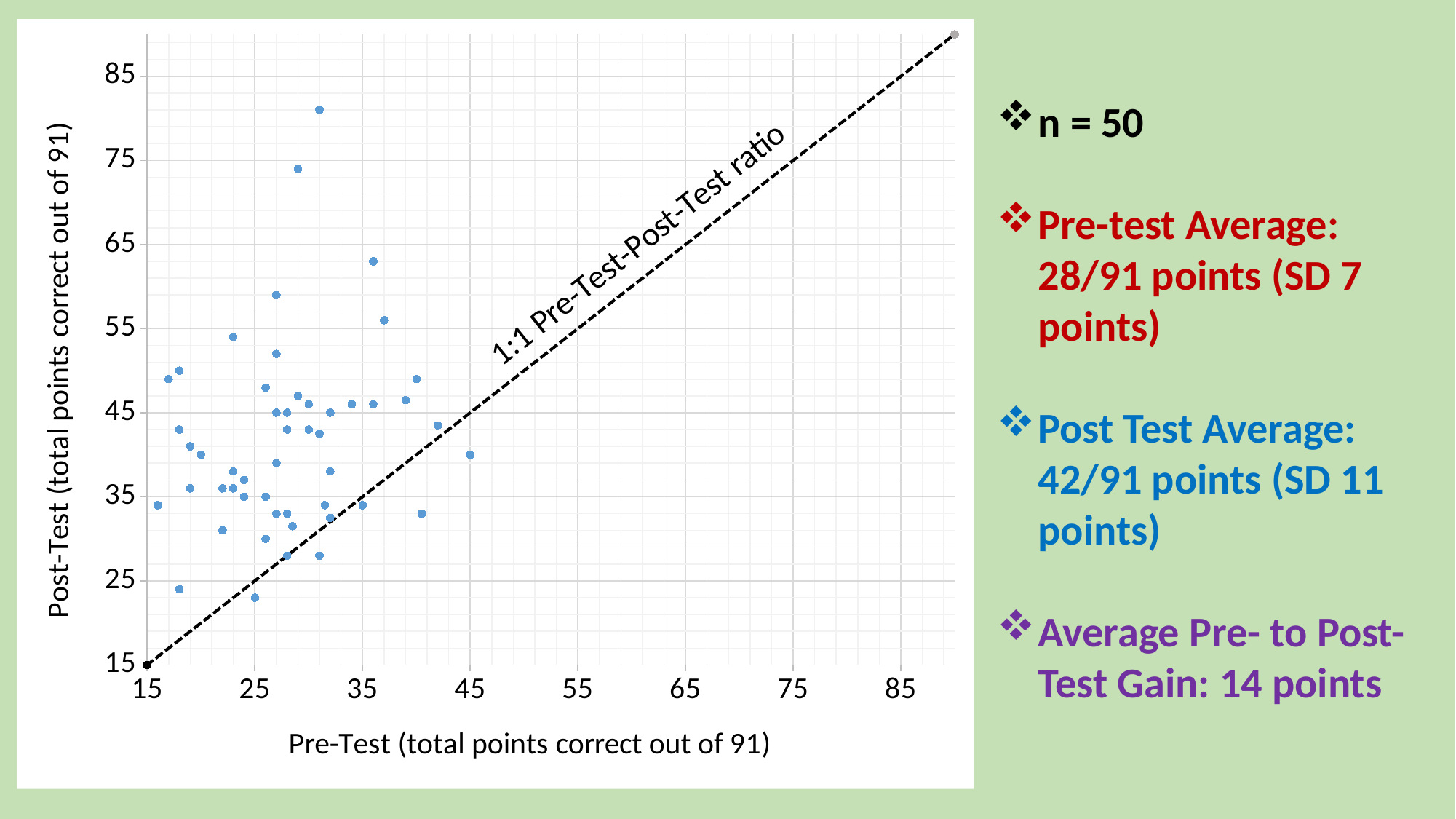
What is the title of the y axis of the chart? Post-Test (total points correct out of 91) What is the title of the x axis of the chart? Pre-Test (total points correct out of 91) Is the lowest Pre-Test value plotted on the chart greater or less than 20? less What is the highest tick value labelled on the y axis of the chart? 85 How many data points (students) are plotted on the chart, according to the slide? 50 Do most of the plotted points lie above or below the dashed 1:1 Pre-Test-Post-Test ratio line? above Is the highest Post-Test value plotted on the chart greater or less than 75? greater What kind of chart is shown on the slide? Scatter chart